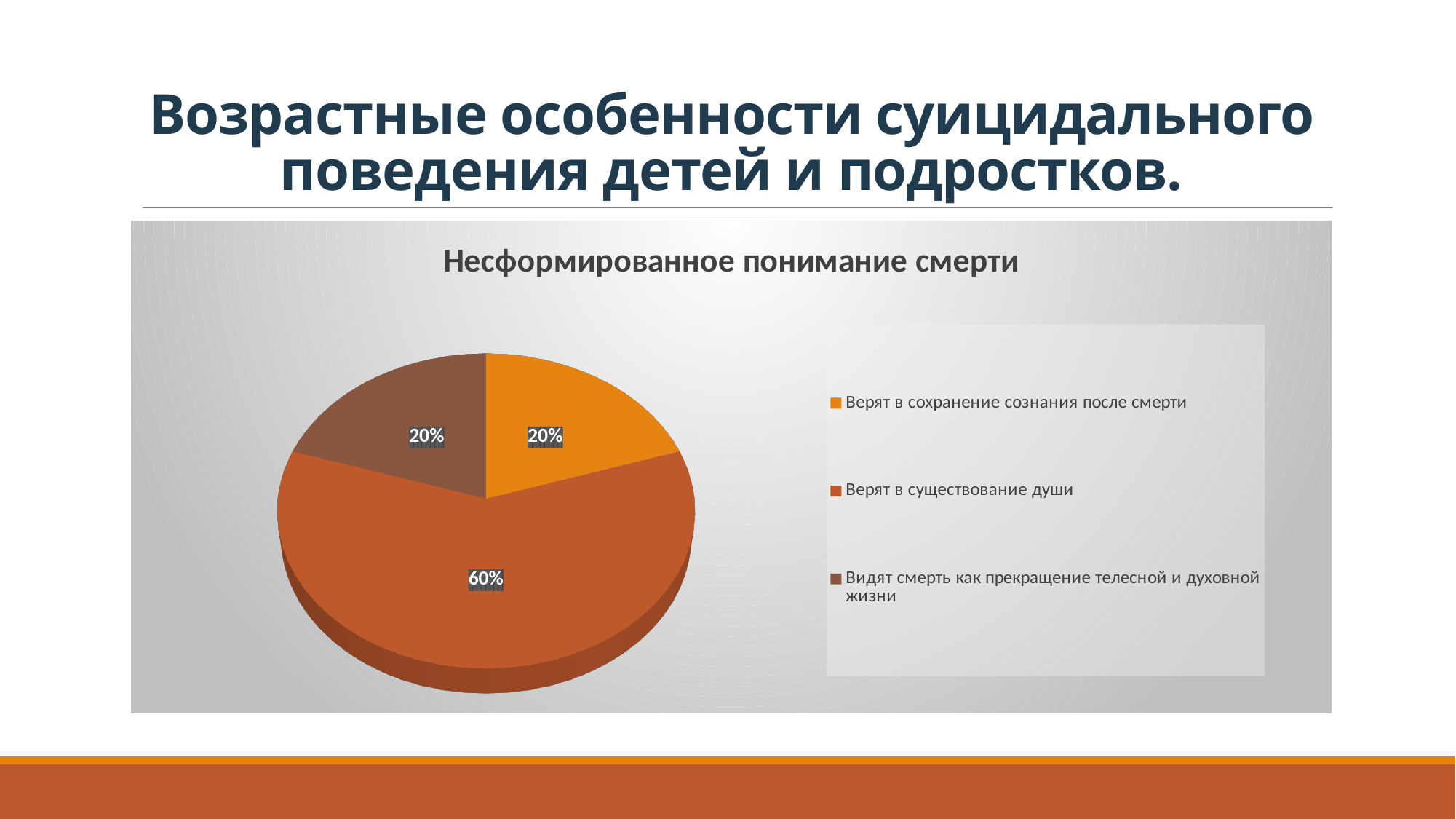
What is the difference between the share for 'Верят в существование души' and the share for 'Верят в сохранение сознания после смерти'? 40% How many entries does the legend list? 3 What kind of chart is shown on the slide? pie chart What share of the pie is 'Верят в существование души'? 60% Which is larger: the share for 'Верят в существование души' or the share for 'Видят смерть как прекращение телесной и духовной жизни'? Верят в существование души What is the title of the chart? Несформированное понимание смерти Which category has the largest slice of the pie? Верят в существование души Is the share for 'Верят в существование души' greater or less than 50%? greater What share of the pie is 'Верят в сохранение сознания после смерти'? 20% What share of the pie is 'Видят смерть как прекращение телесной и духовной жизни'? 20% What colour is the slice for 'Верят в сохранение сознания после смерти'? orange How many slices does the pie chart have? 3